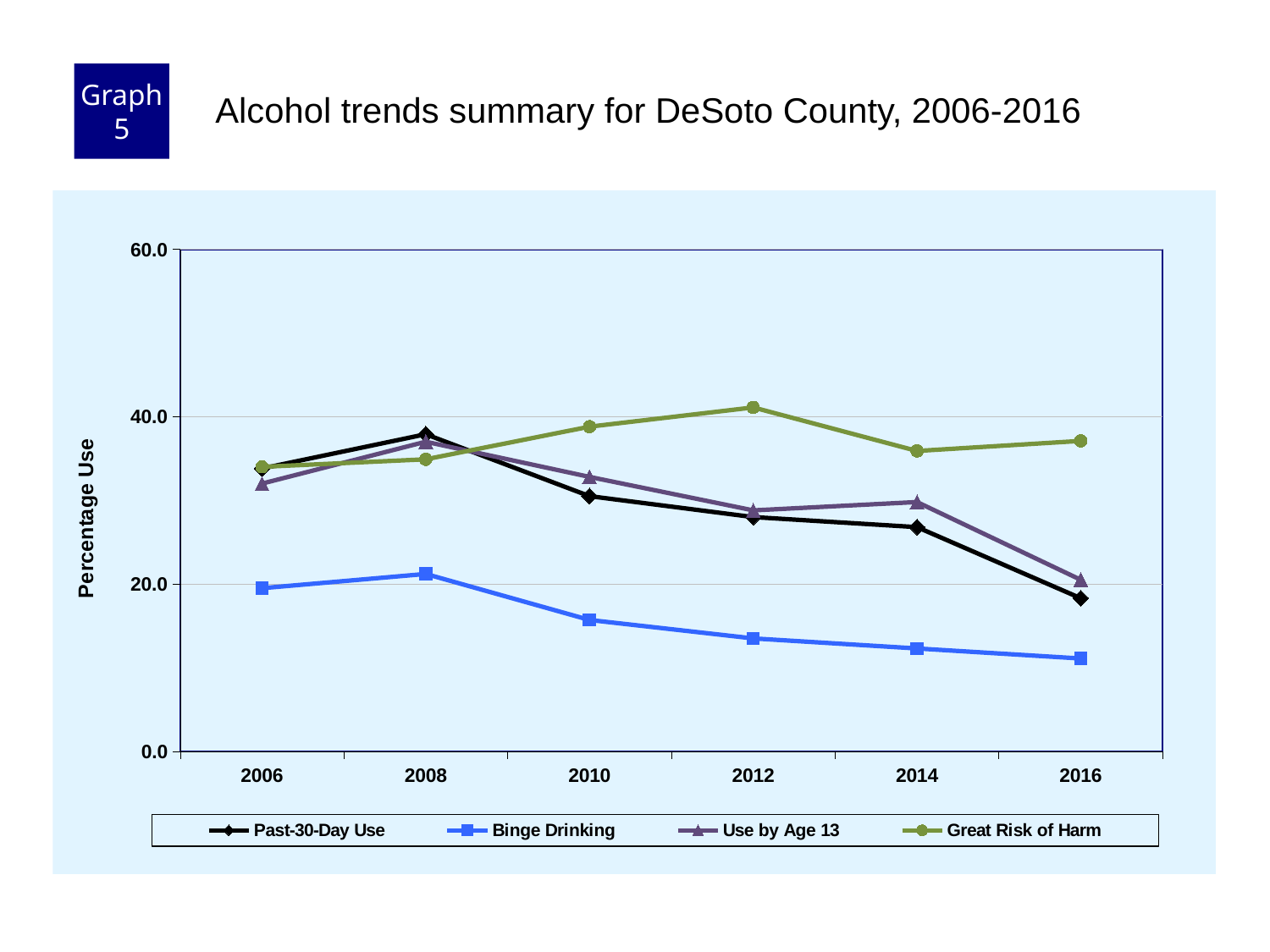
How many series does the legend list? 4 Which is larger in 2012, Great Risk of Harm or Binge Drinking? Great Risk of Harm Does the Binge Drinking series rise or fall from 2008 to 2016? Fall Which series has the lowest value in 2016? Binge Drinking Is the value for Binge Drinking in 2016 greater or less than 20.0? less Is the value for Great Risk of Harm in 2014 greater or less than 40.0? less What is the label on the y axis? Percentage Use How many years are plotted along the x axis? 6 Is the value for Past-30-Day Use in 2008 greater or less than 40.0? less What is the title of the chart? Alcohol trends summary for DeSoto County, 2006-2016 What kind of chart is shown on the slide? Line chart Which series has the highest value in 2016? Great Risk of Harm